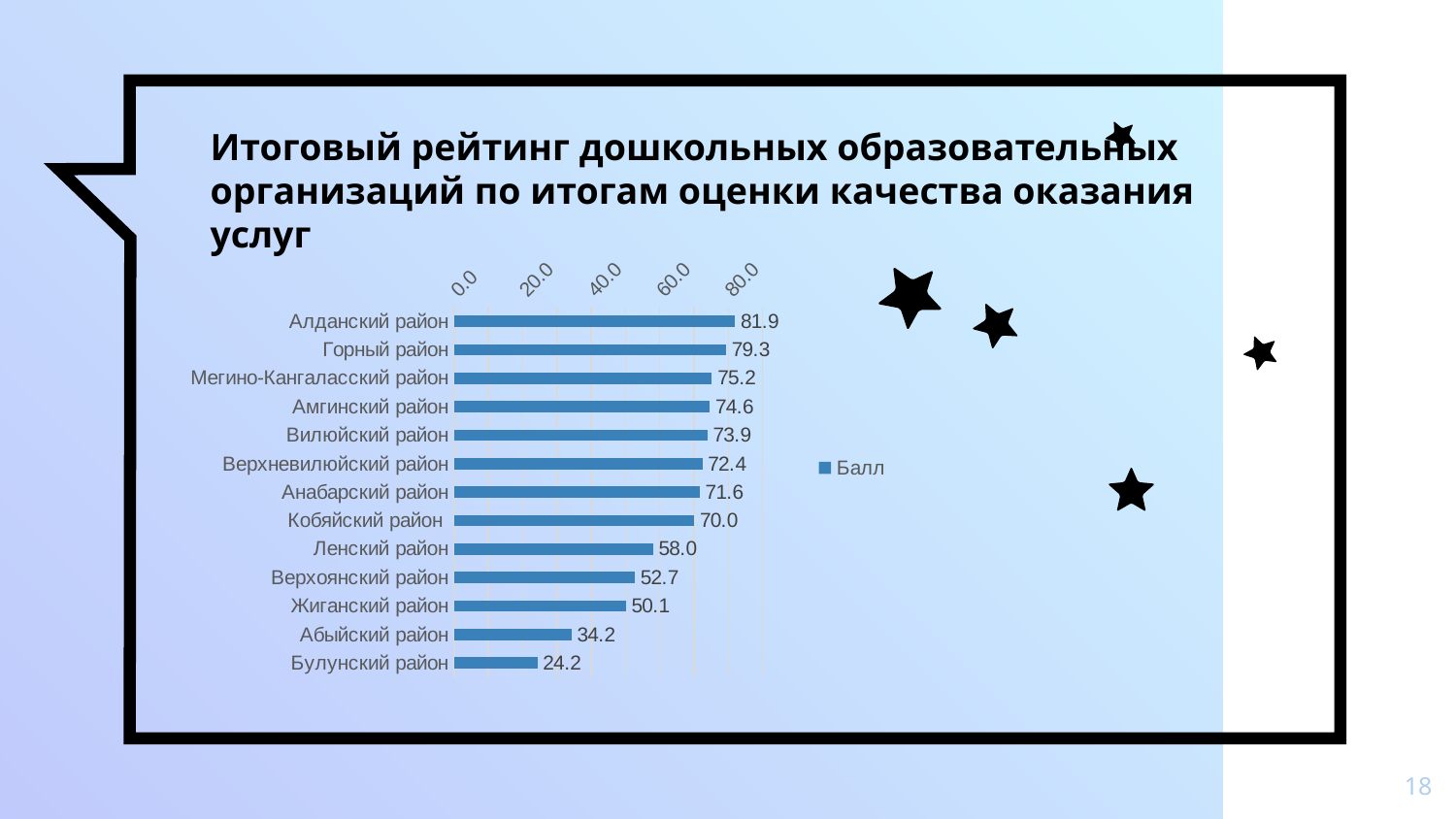
Which is larger, the value for Горный район or the value for Абыйский район? Горный район What is the value for Кобяйский район? 70.0 Is the value for Жиганский район greater or less than 40.0? greater Which district has the highest value? Алданский район What kind of chart is shown on the slide? bar chart How many districts are shown in the chart? 13 What is the difference between the values for Ленский район and Верхоянский район? 5.3 What is the difference between the values for Алданский район and Булунский район? 57.7 What is the value for Булунский район? 24.2 Which district has the lowest value? Булунский район How many series does the legend list? 1 What is the value for Алданский район? 81.9